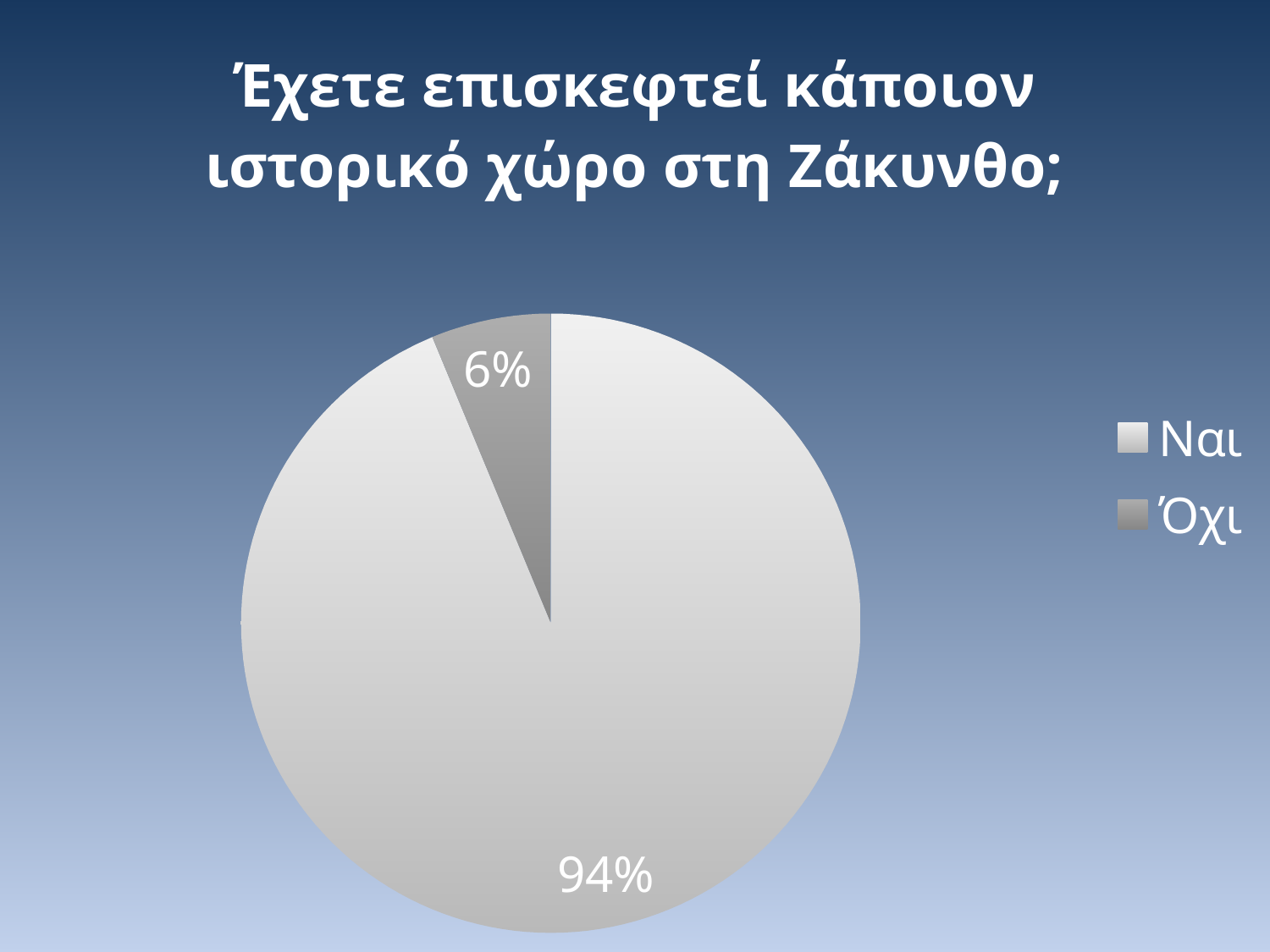
Which category has the smallest share of the pie? Όχι What is the title of the chart? Έχετε επισκεφτεί κάποιον ιστορικό χώρο στη Ζάκυνθο; What is the difference in percentage points between Ναι and Όχι? 88 What percentage of the pie is labelled for Όχι? 6% Which legend entry is shown in the darker grey colour? Όχι Which is larger, the share for Ναι or the share for Όχι? Ναι What type of chart is shown on the slide? pie chart How many entries does the legend list? 2 Which category has the largest share of the pie? Ναι How many slices does the pie chart have? 2 What percentage of the pie is labelled for Ναι? 94%